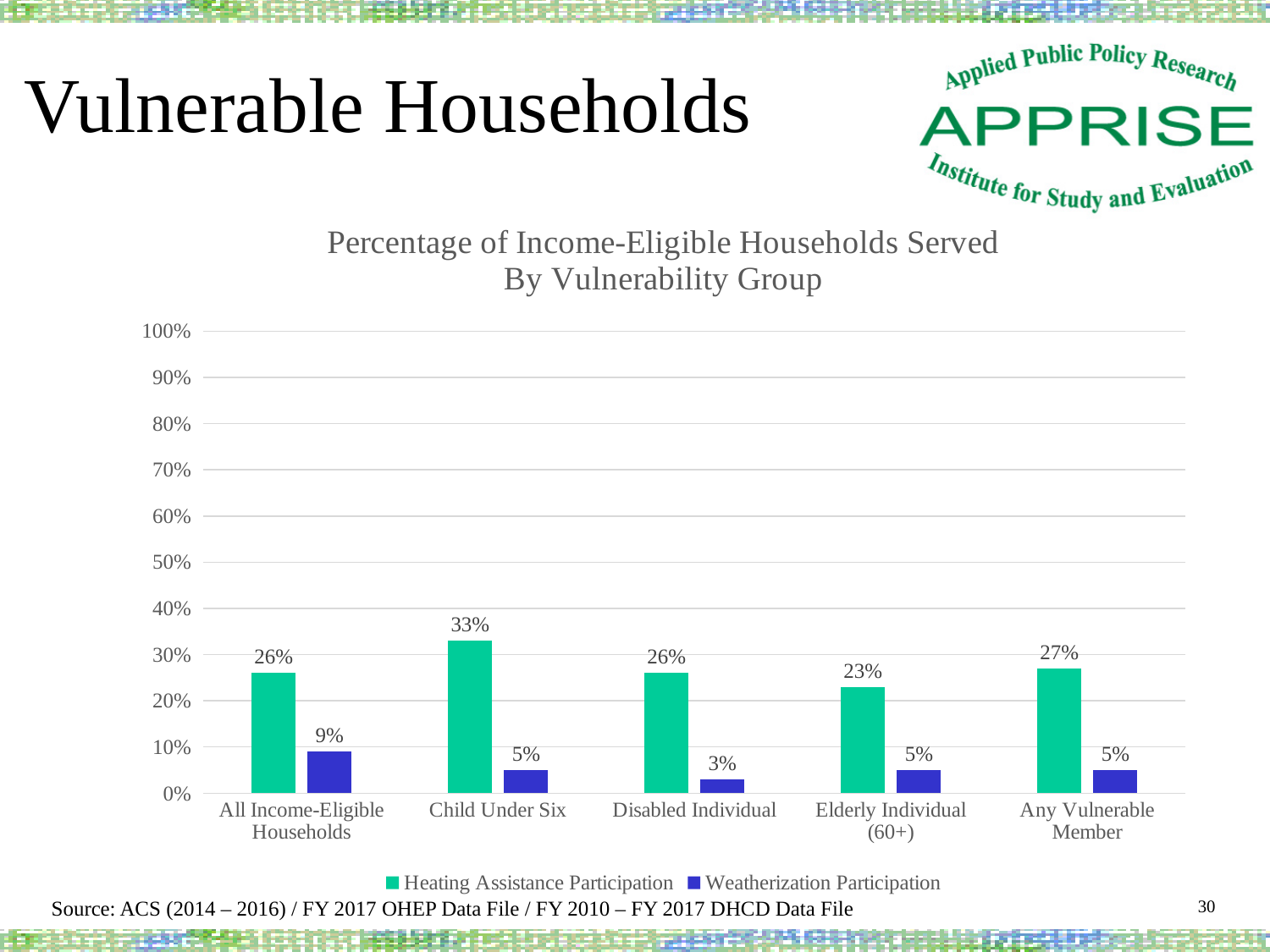
Which category has the highest Heating Assistance Participation? Child Under Six What is the difference between Heating Assistance Participation and Weatherization Participation for Child Under Six? 28% How many vulnerability group categories are shown on the x axis? 5 What is the Weatherization Participation value for Disabled Individual? 3% Which is larger: Heating Assistance Participation for Any Vulnerable Member or for Elderly Individual (60+)? Any Vulnerable Member Which category has the lowest Weatherization Participation? Disabled Individual What is the title of the chart? Percentage of Income-Eligible Households Served By Vulnerability Group What kind of chart is shown on the slide? Bar chart How many series does the legend list? 2 What is the Heating Assistance Participation value for Elderly Individual (60+)? 23% What is the Weatherization Participation value for All Income-Eligible Households? 9% What is the Heating Assistance Participation value for Child Under Six? 33%